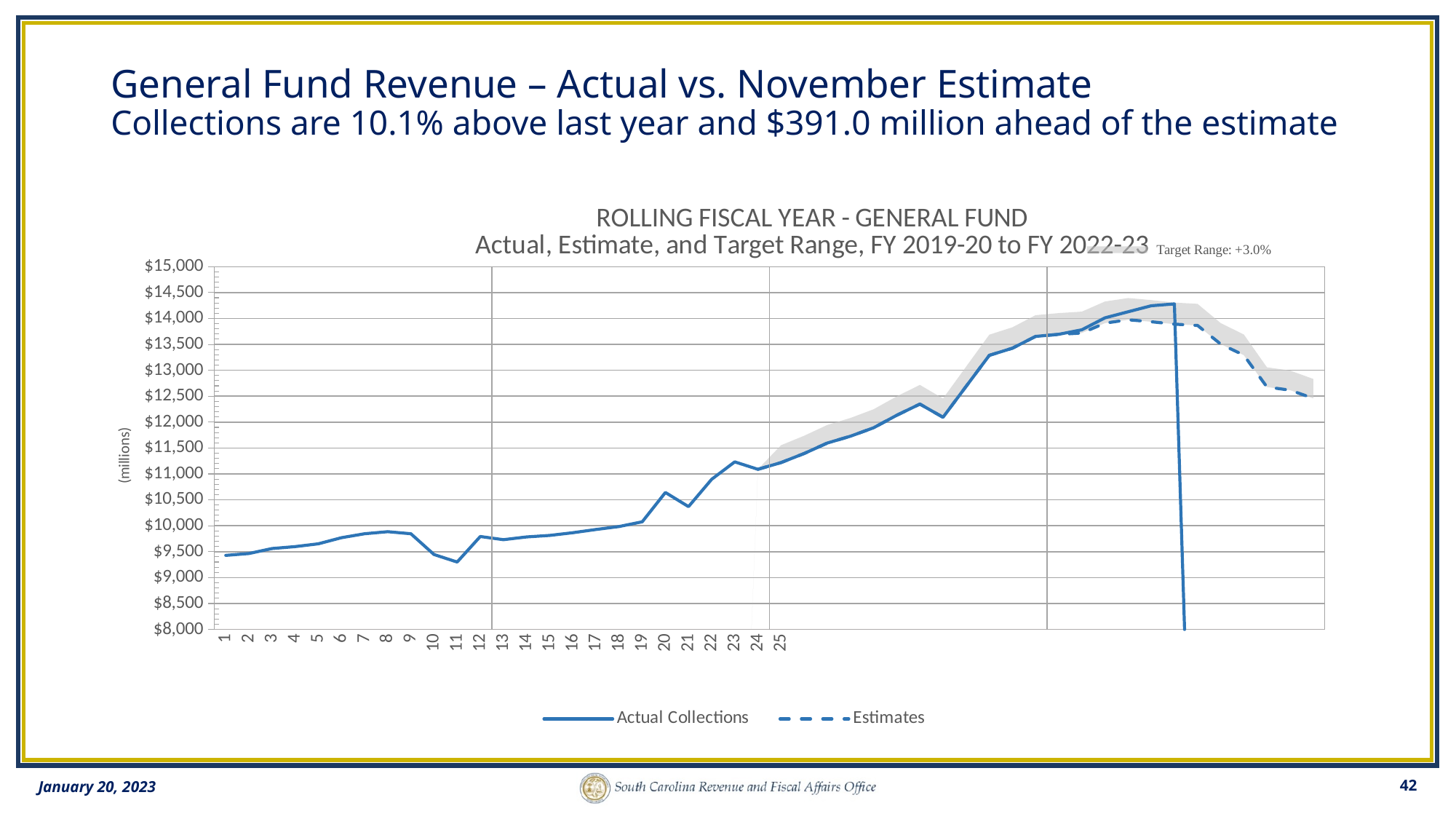
Which is larger, the Actual Collections value at point 6 or at point 11? point 6 Do the Actual Collections values generally rise or fall from point 1 to point 25? rise Is the Actual Collections value at point 6 greater or less than $9,500? greater How many series does the chart legend list? 2 What are the two series named in the chart legend? Actual Collections and Estimates Is the Actual Collections value at point 21 greater or less than $10,500? less What is the target range noted at the top right of the chart? +3.0% Is the Actual Collections value at point 23 greater or less than $11,000? greater Which is larger, the Actual Collections value at point 1 or at point 23? point 23 What kind of chart is shown on the slide? line chart